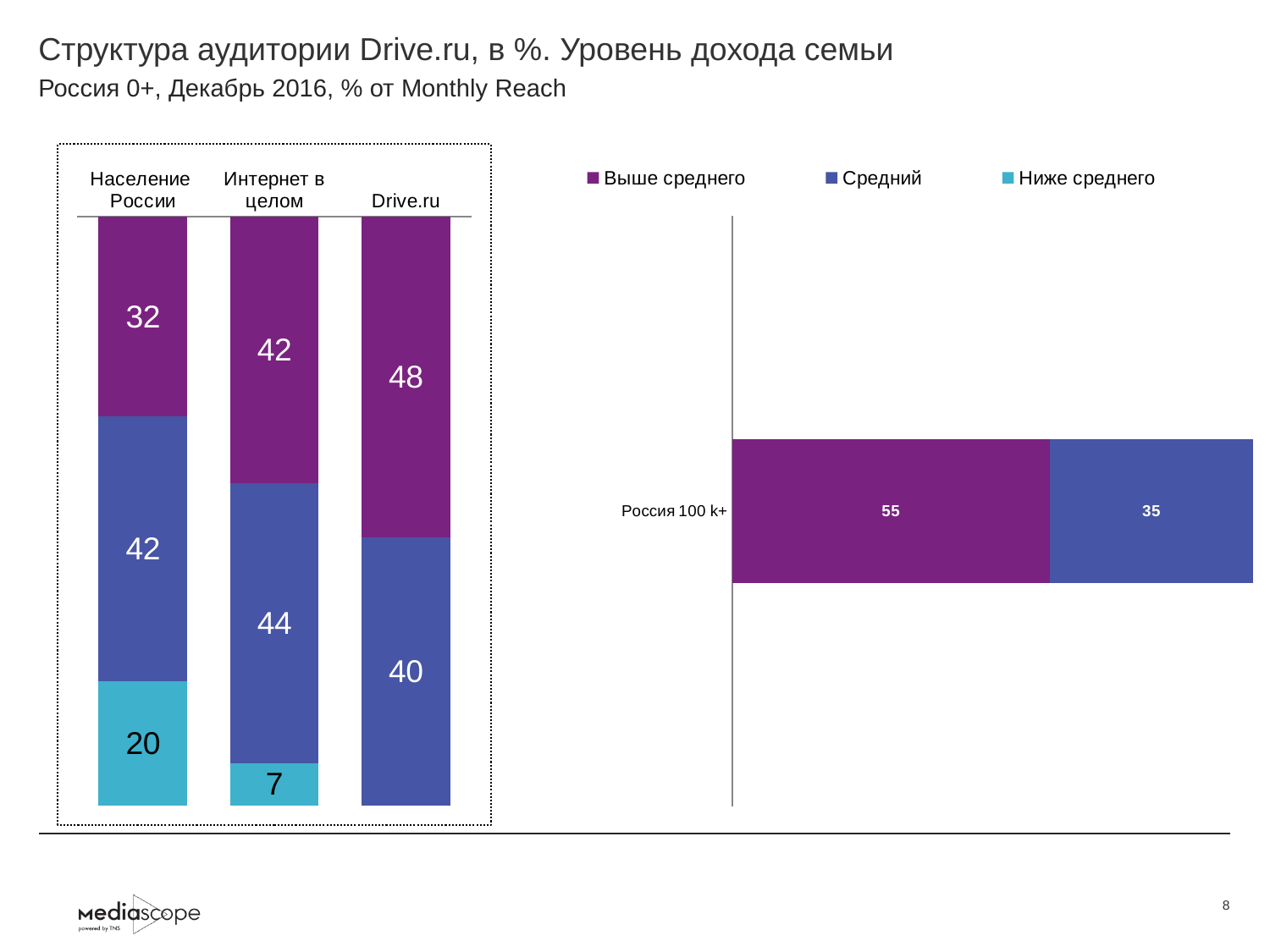
In the left chart, which category has the highest value for Выше среднего? Drive.ru How many series does the legend list? 3 In the left chart, what is the value of Выше среднего for Drive.ru? 48 In the left chart, what is the difference between the Выше среднего values for Drive.ru and Население России? 16 In the right chart, what is the difference between the Выше среднего and Средний values for Россия 100 k+? 20 In the left chart, what is the value of Ниже среднего for Население России? 20 What kind of chart is the left chart? Stacked bar chart In the left chart, what is the value of Средний for Интернет в целом? 44 In the left chart, which category has the lowest value for Средний? Drive.ru How many categories are shown in the left chart? 3 In the right chart, what is the Выше среднего value for Россия 100 k+? 55 In the left chart, which has the larger Средний value: Население России or Интернет в целом? Интернет в целом